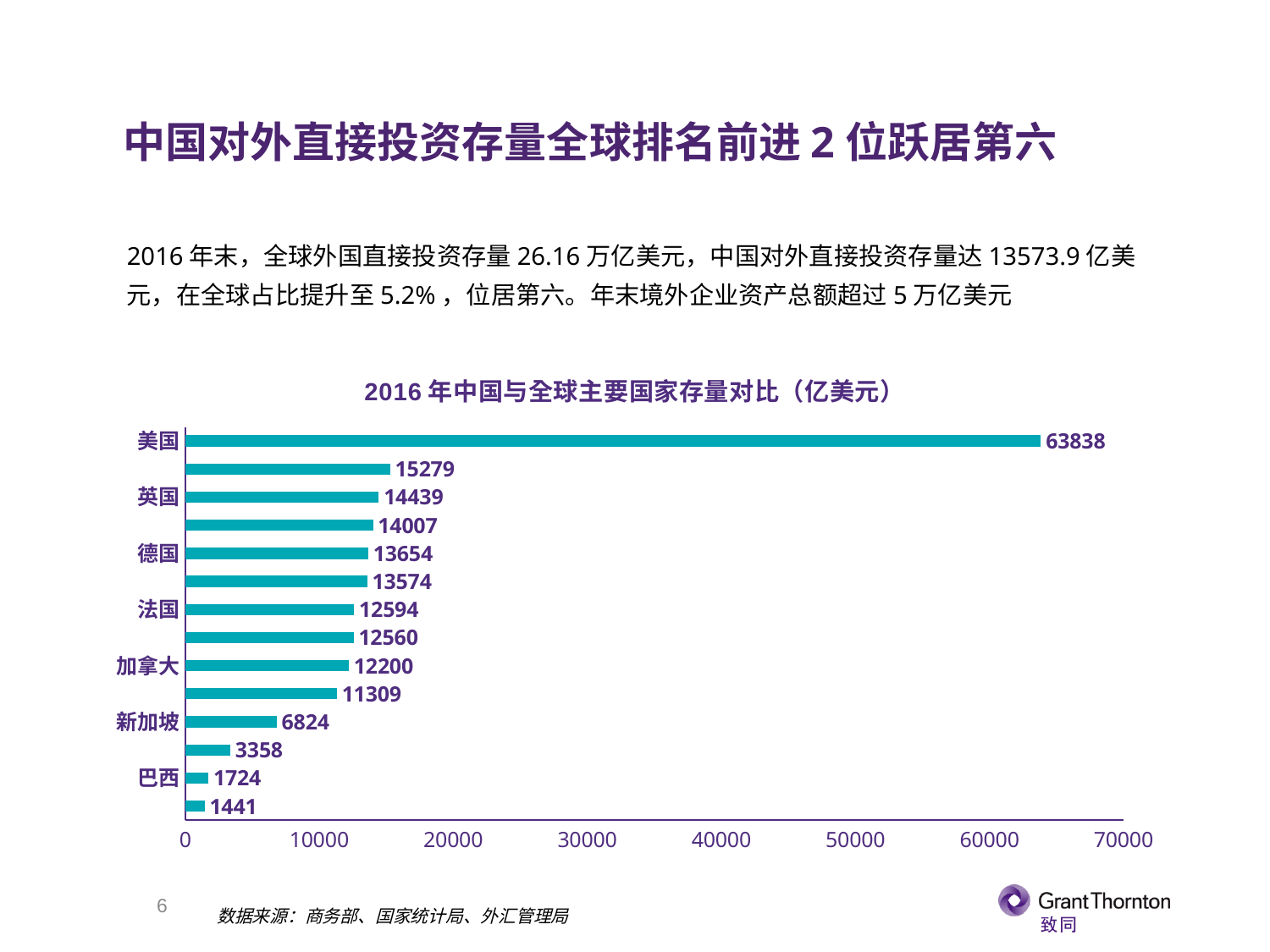
What kind of chart is shown on the slide? bar chart What is the value for 德国 in the chart? 13654 What is the value for 法国 in the chart? 12594 What is the value for 新加坡 in the chart? 6824 Which has the larger value, 德国 or 法国? 德国 What is the value for 加拿大 in the chart? 12200 Which labelled country has the highest value in the chart? 美国 What is the value for 美国 in the chart? 63838 What is the value for 英国 in the chart? 14439 What is the value for 巴西 in the chart? 1724 How many bars are plotted in the chart? 14 What is the difference between the values for 美国 and 英国? 49399